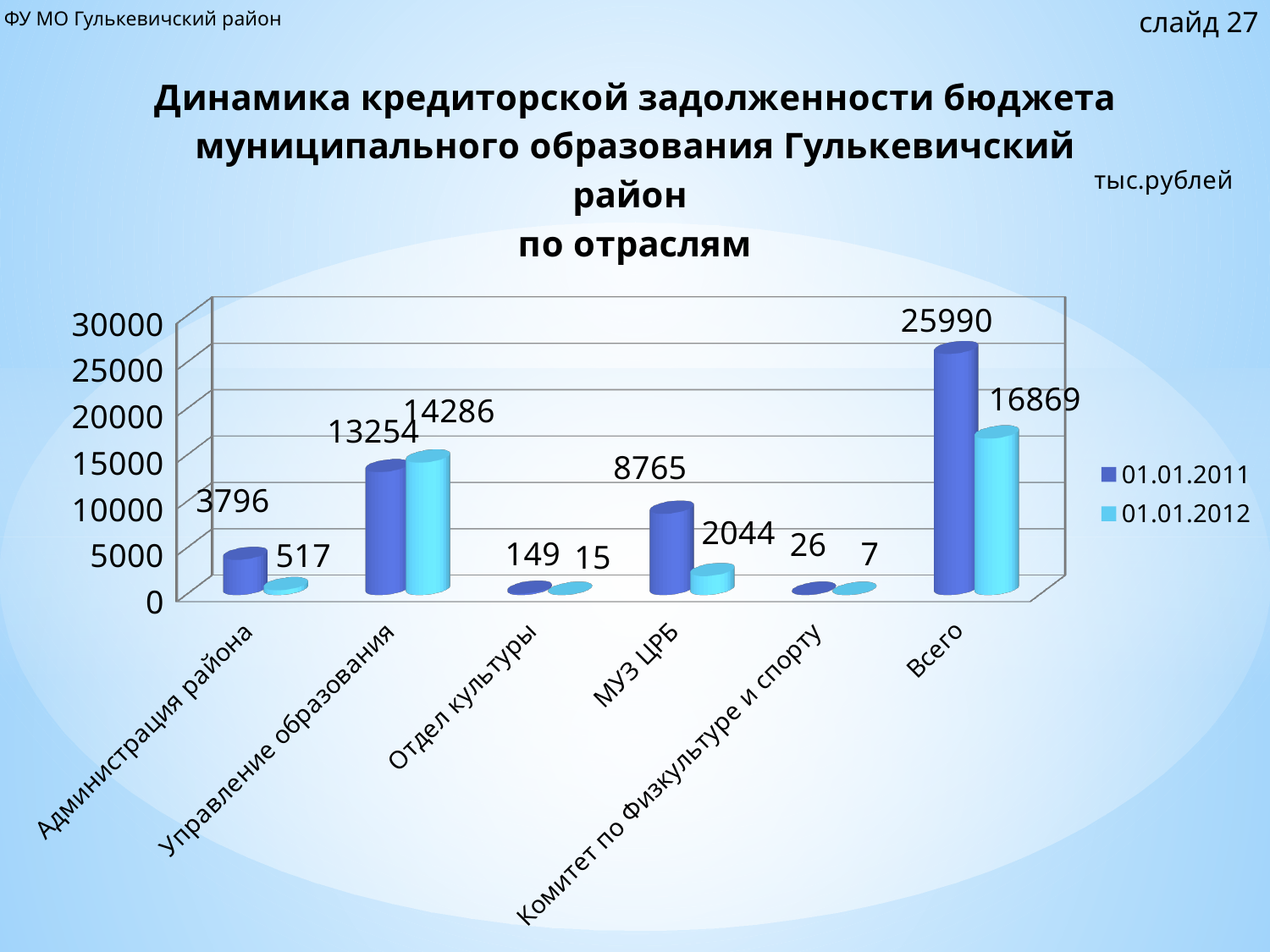
What is the value for Управление образования in the 01.01.2012 series? 14286 What is the difference between the 01.01.2011 and 01.01.2012 values for Всего? 9121 What kind of chart is shown on the slide? Bar chart How many series does the legend list? 2 Which category has the lowest value in the 01.01.2012 series? Комитет по физкультуре и спорту For Управление образования, which series has the larger value: 01.01.2011 or 01.01.2012? 01.01.2012 What unit is indicated next to the chart title? тыс.рублей How many categories are shown on the x axis? 6 What is the value for Комитет по физкультуре и спорту in the 01.01.2011 series? 26 What is the value for МУЗ ЦРБ in the 01.01.2012 series? 2044 What is the value for Администрация района in the 01.01.2011 series? 3796 Excluding Всего, which category has the highest value in the 01.01.2011 series? Управление образования